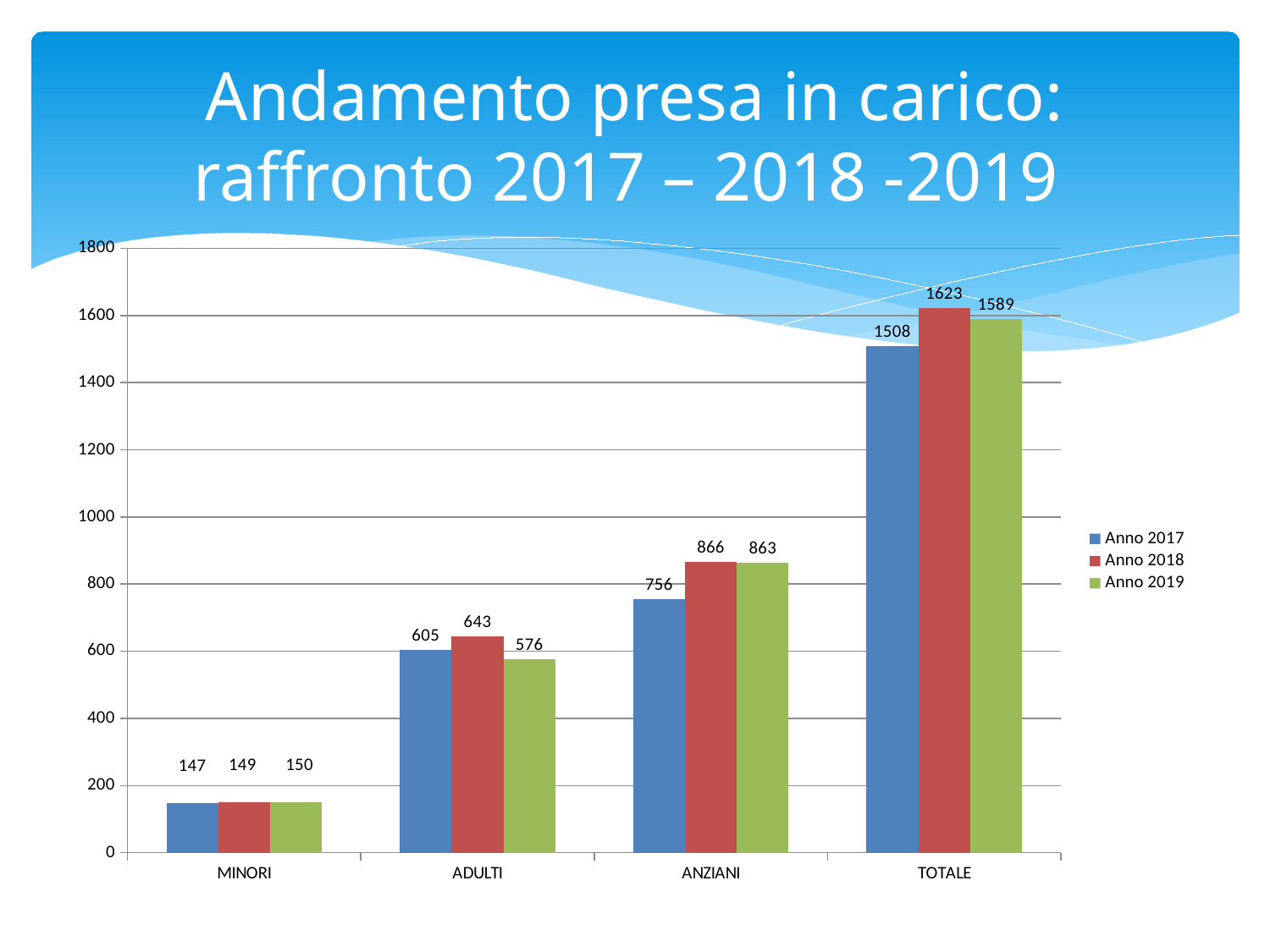
What kind of chart is shown on the slide? bar chart How many categories are shown on the x axis? 4 What is the difference between the Anno 2018 and Anno 2017 values for TOTALE? 115 Is the Anno 2017 value for ANZIANI greater or less than 800? less What is the value for ANZIANI in Anno 2017? 756 Which category has the lowest value in Anno 2019? MINORI What is the value for TOTALE in Anno 2019? 1589 How many series does the legend list? 3 Which category has the highest value in Anno 2018? TOTALE What is the difference between the Anno 2018 and Anno 2019 values for ADULTI? 67 Which is larger for ADULTI: the Anno 2017 value or the Anno 2019 value? Anno 2017 What is the value for ADULTI in Anno 2018? 643